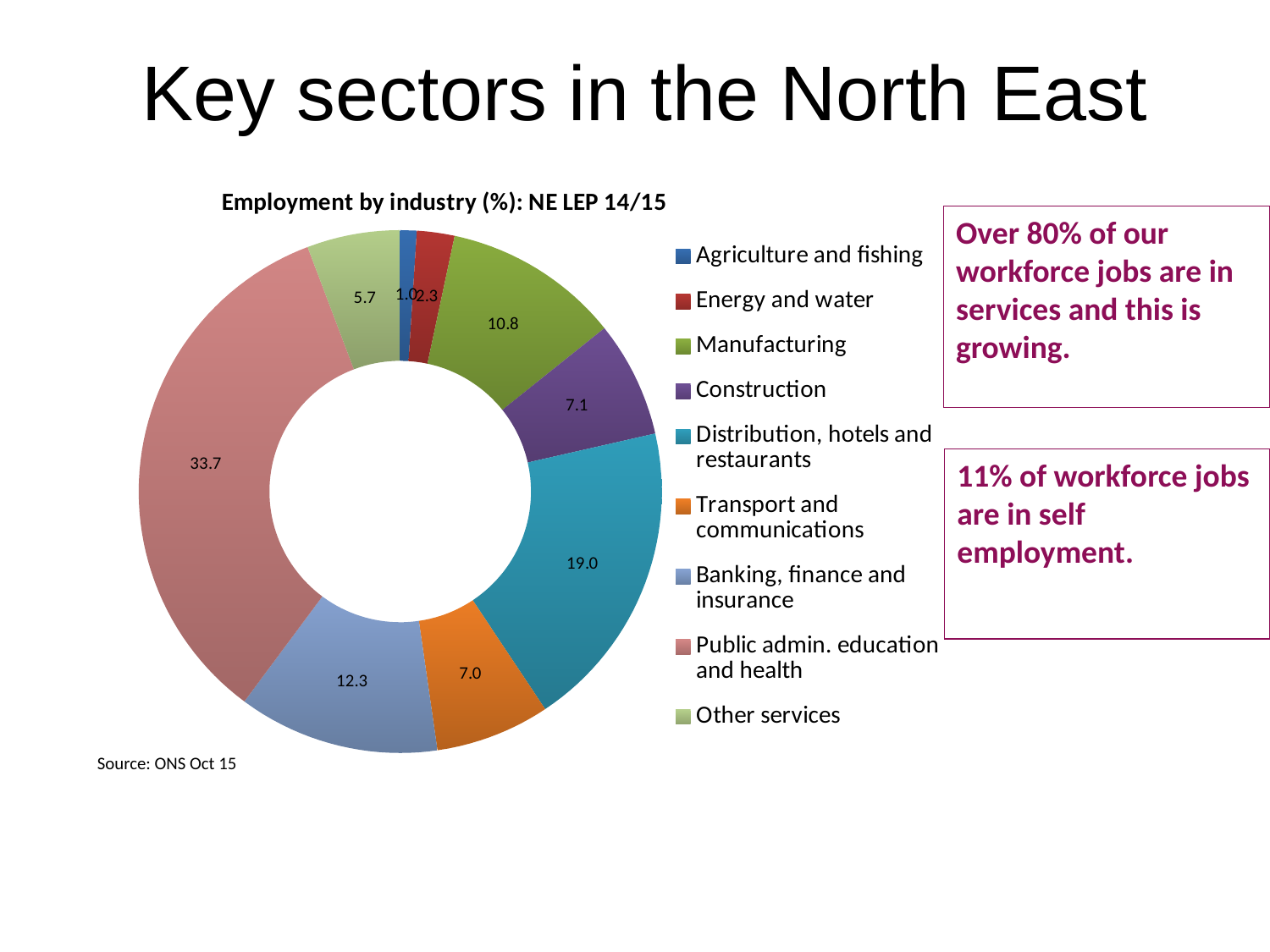
Which is larger, Construction or Transport and communications? Construction What is the value for Banking, finance and insurance? 12.3 What is the value for Public admin. education and health in the Employment by industry chart? 33.7 What is the value for Distribution, hotels and restaurants? 19.0 What is the difference between the values for Public admin. education and health and Distribution, hotels and restaurants? 14.7 How many industry categories does the chart show? 9 What is the value for Other services? 5.7 What kind of chart is shown on the slide? doughnut chart What is the title of the chart? Employment by industry (%): NE LEP 14/15 What is the value for Manufacturing? 10.8 Which industry has the largest share of employment? Public admin. education and health Which industry has the smallest share of employment? Agriculture and fishing